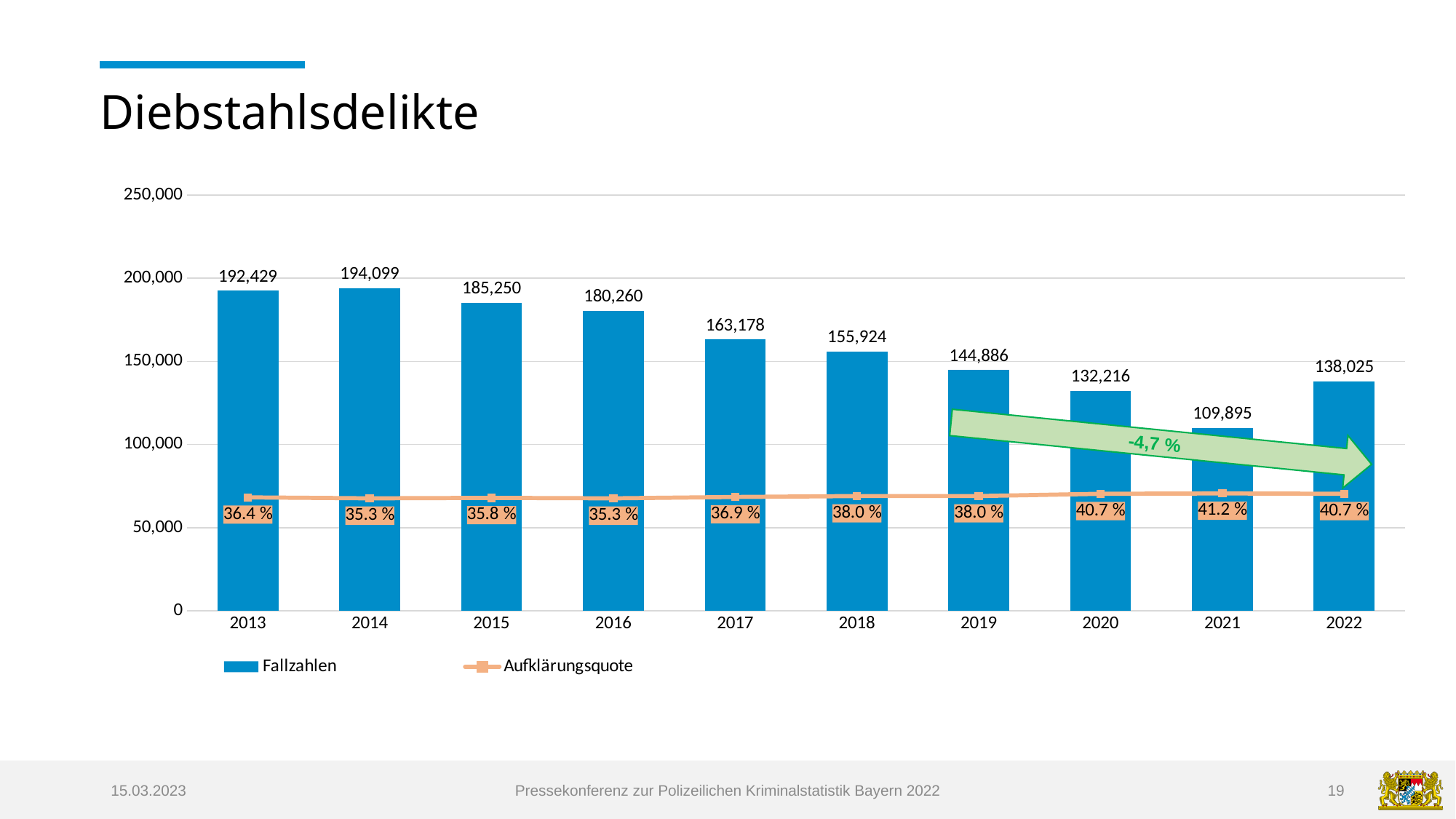
Do the Fallzahlen values generally rise or fall from 2013 to 2021? fall What is the Fallzahlen value for 2016? 180,260 What kind of chart is shown on the slide? A bar chart combined with a line Which year has the highest Fallzahlen? 2014 How many years are shown on the x axis? 10 Which year has the lowest Fallzahlen? 2021 How many series does the legend list? 2 What is the difference between the Fallzahlen for 2013 and 2022? 54,404 Which year has the highest Aufklärungsquote? 2021 What is the Aufklärungsquote for 2021? 41.2 % Which year has the larger Fallzahlen, 2019 or 2020? 2019 Is the Fallzahlen value for 2018 greater or less than 150,000? greater